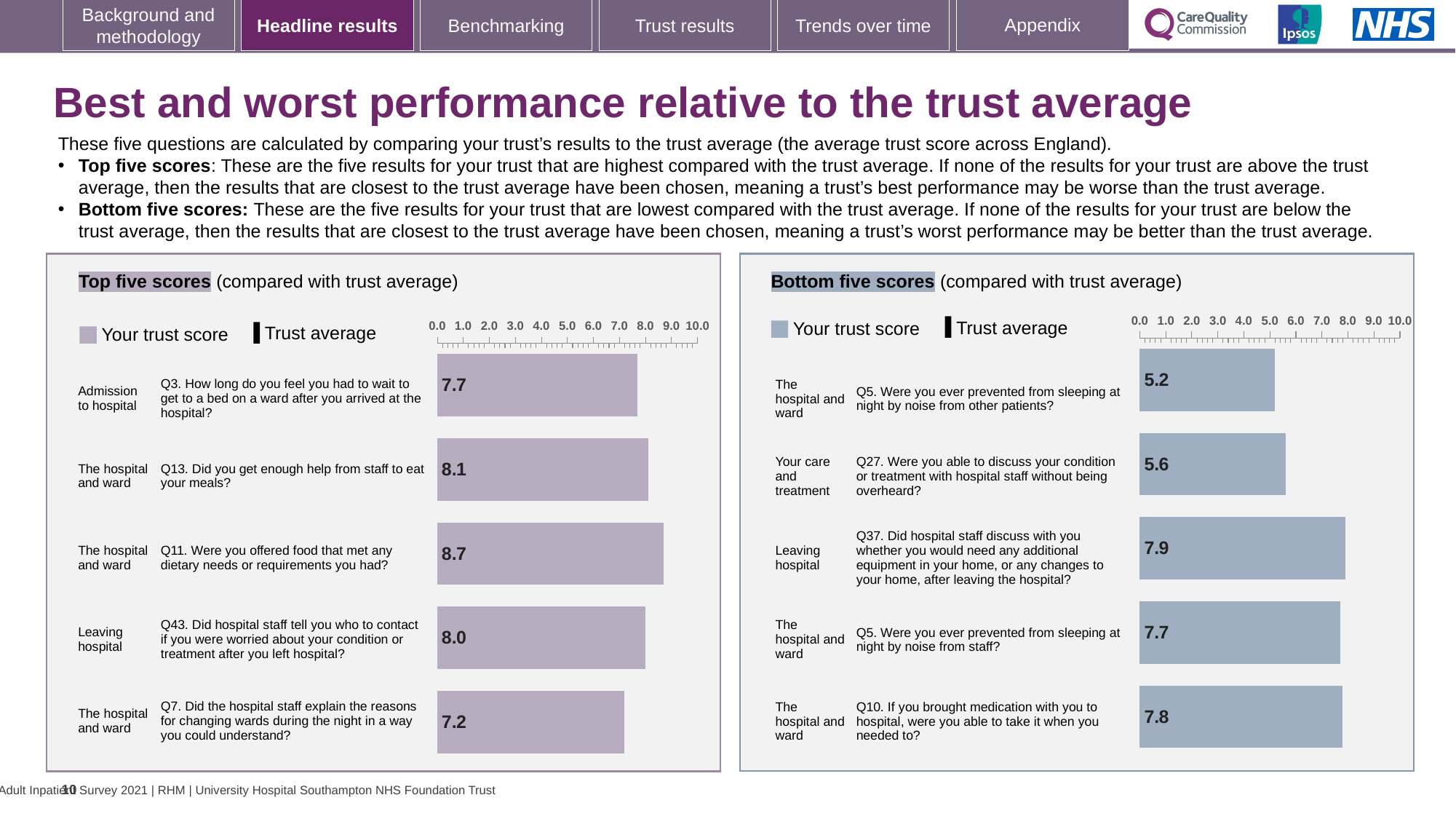
What kind of chart is used in the Top five scores panel? Bar chart In the Top five scores chart, what is the difference between the highest score (Q11) and the lowest score (Q7)? 1.5 In the Top five scores chart, which question has the highest trust score? Q11. Were you offered food that met any dietary needs or requirements you had? How many questions are shown in the Bottom five scores chart? 5 In the Bottom five scores chart, which has the larger score: Q10 (medication) or Q5 (noise from staff)? Q10 (7.8) In the Top five scores chart, is the score for Q3 greater or less than 7.0? greater How many series does the legend of the Top five scores chart list? 2 In the Bottom five scores chart, what is the trust score for Q27 (Were you able to discuss your condition or treatment with hospital staff without being overheard?)? 5.6 In the Bottom five scores chart, which question has the lowest trust score? Q5. Were you ever prevented from sleeping at night by noise from other patients? In the Bottom five scores chart, what is the difference between the score for Q37 and the score for Q5 (noise from other patients)? 2.7 In the Top five scores chart, what is the trust score for Q13 (Did you get enough help from staff to eat your meals?)? 8.1 In the Top five scores chart, which question has the lowest trust score? Q7. Did the hospital staff explain the reasons for changing wards during the night in a way you could understand?